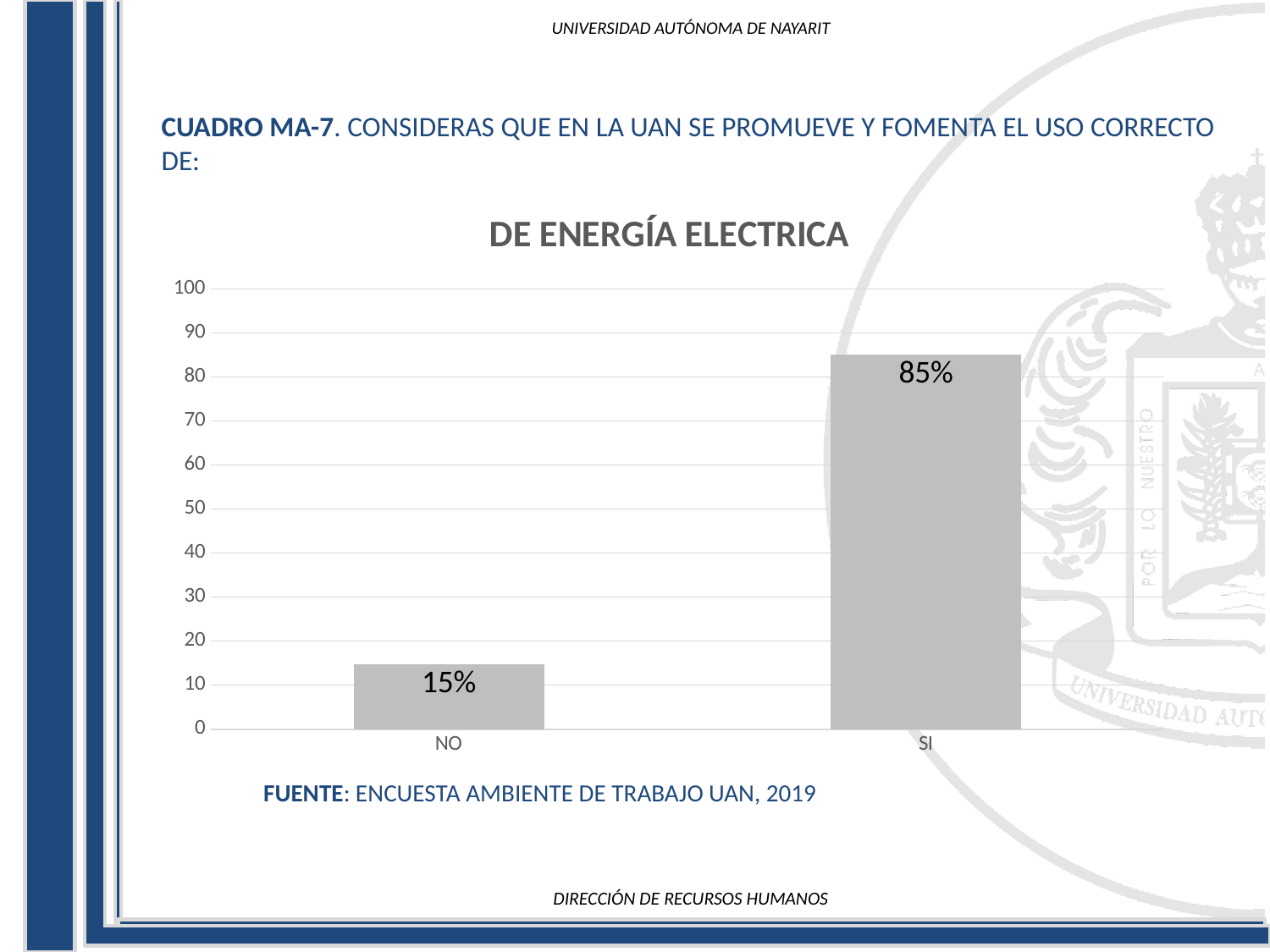
What is the difference between the values for SI and NO? 70% Which category has the highest value? SI What is the title of the chart? DE ENERGÍA ELECTRICA What is the value for NO? 15% Which category has the lowest value? NO What is the value for SI? 85% What is the maximum value shown on the y axis? 100 Which is larger, the value for NO or the value for SI? SI How many categories are shown on the x axis? 2 Is the value for NO greater or less than 20? less Is the value for SI greater or less than 80? greater What kind of chart is shown on the slide? bar chart